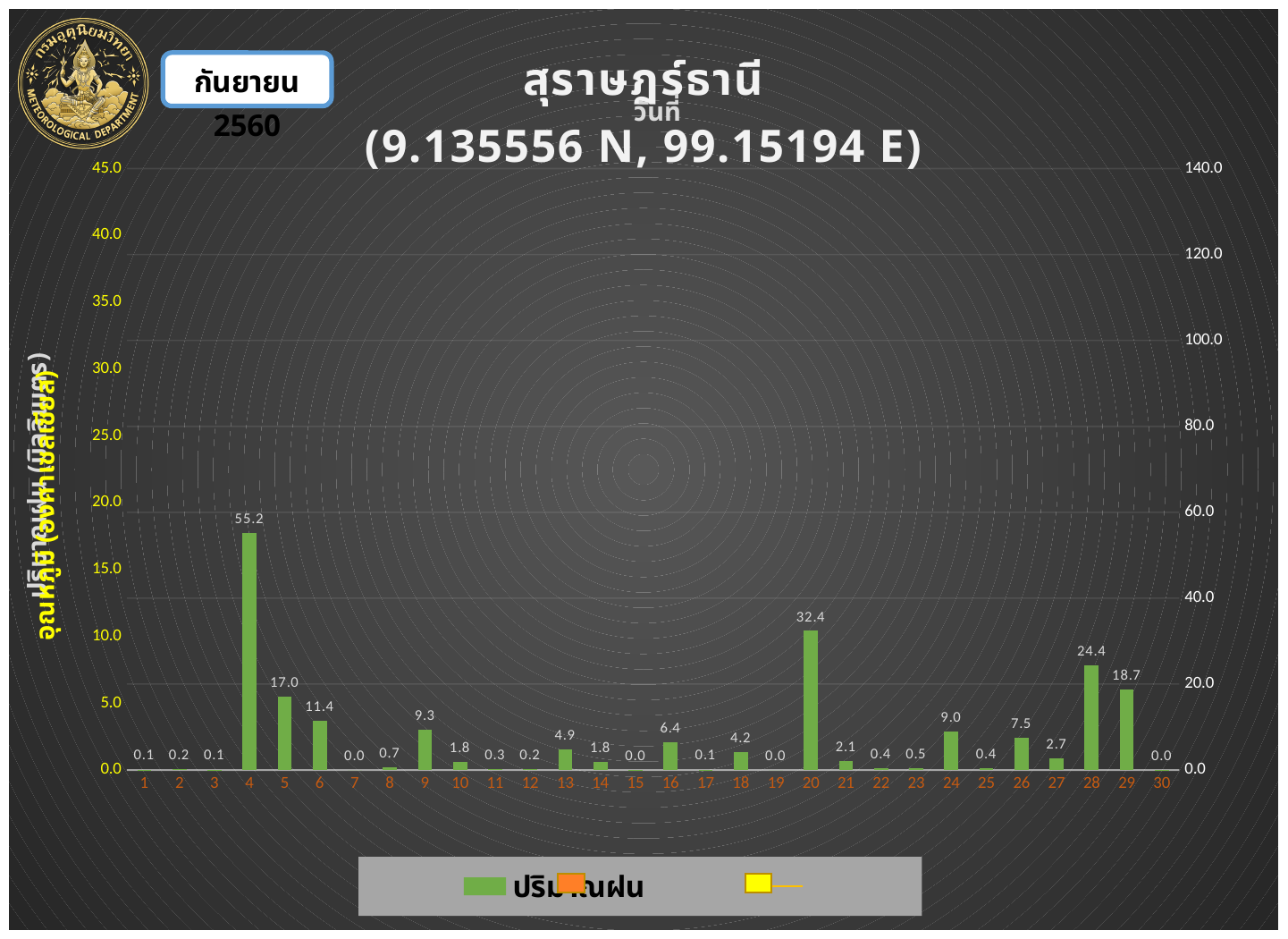
What is the value shown for day 20? 32.4 Which day has the highest bar in the chart? 4 Which is larger, the value for day 9 or the value for day 24? day 9 What is the value shown for day 29? 18.7 What is the value shown for day 28? 24.4 How many days are shown on the x axis of the chart? 30 What is the rainfall value shown for day 4? 55.2 Which is larger, the value for day 5 or the value for day 6? day 5 What is the difference between the values for day 4 and day 20? 22.8 What is the coordinate pair shown in the chart title? (9.135556 N, 99.15194 E) What kind of chart is shown on the slide? bar chart What is the difference between the values for day 28 and day 29? 5.7